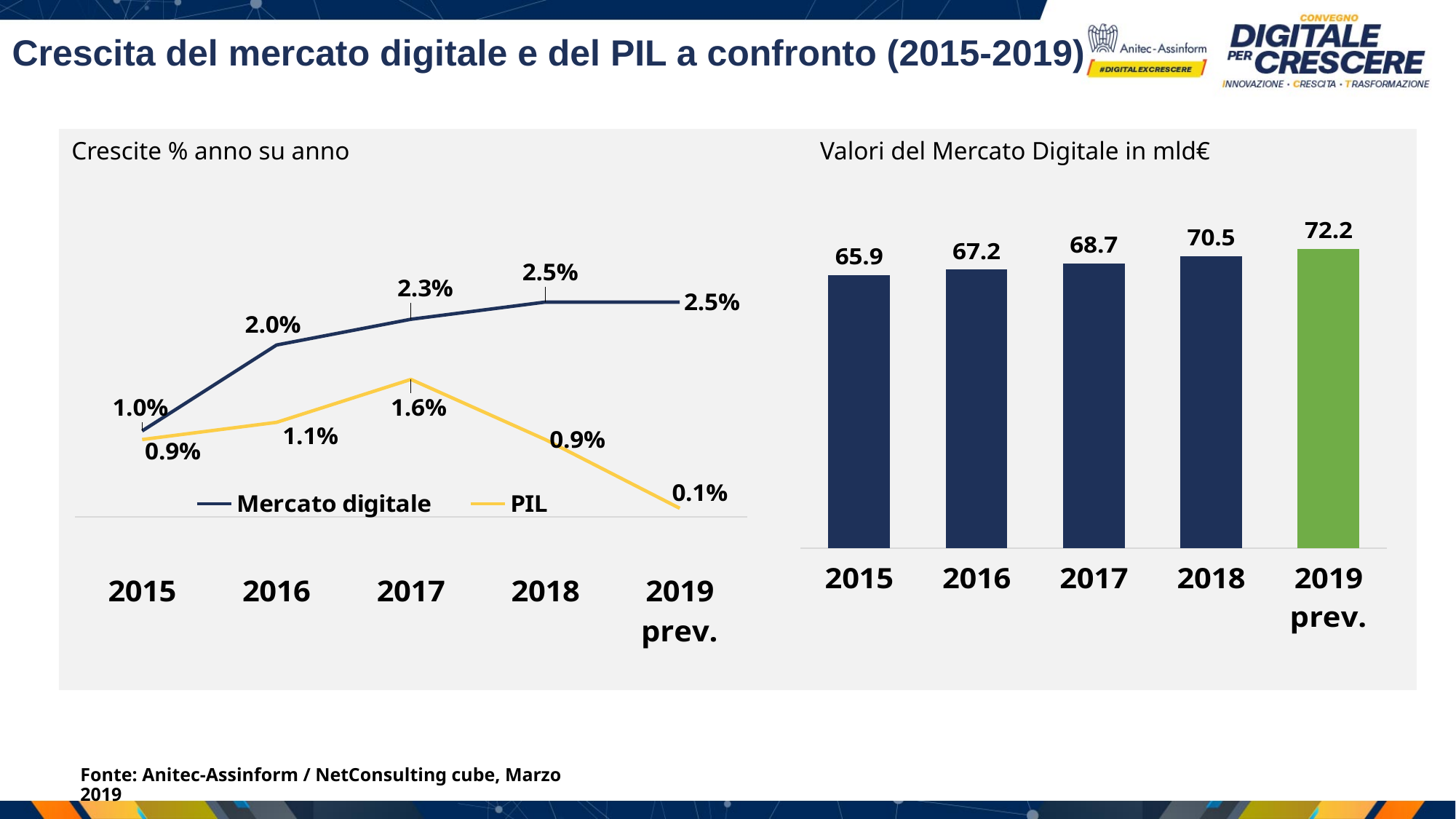
What kind of chart is the right chart 'Valori del Mercato Digitale in mld€'? bar chart In the left chart 'Crescite % anno su anno', in which year is the PIL growth highest? 2017 In the left chart 'Crescite % anno su anno', how many series does the legend list? 2 In the right chart 'Valori del Mercato Digitale in mld€', how many bars are there? 5 In the left chart 'Crescite % anno su anno', what is the difference between Mercato digitale and PIL in 2018? 1.6% In the left chart 'Crescite % anno su anno', what is the value for PIL in 2019 prev.? 0.1% In the left chart 'Crescite % anno su anno', in which year is the Mercato digitale growth lowest? 2015 In the left chart 'Crescite % anno su anno', which is larger in 2016: Mercato digitale or PIL? Mercato digitale In the left chart 'Crescite % anno su anno', what is the value for Mercato digitale in 2017? 2.3% In the left chart 'Crescite % anno su anno', does the PIL line rise or fall from 2017 to 2019 prev.? fall In the right chart 'Valori del Mercato Digitale in mld€', what is the difference between 2019 prev. and 2015? 6.3 In the right chart 'Valori del Mercato Digitale in mld€', what is the value for 2018? 70.5